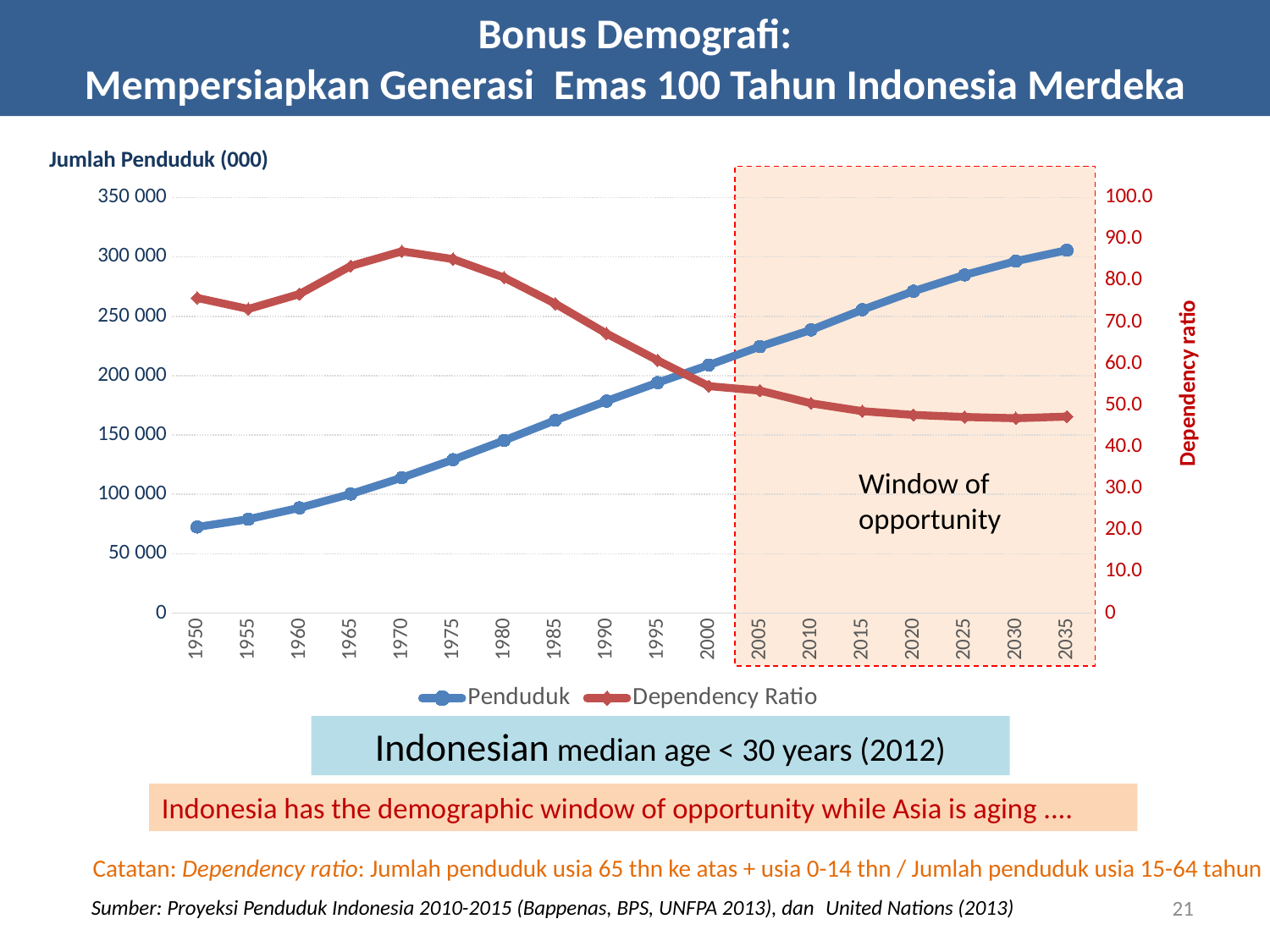
Does the Penduduk series rise or fall from 1950 to 2035? rise How many years are plotted along the x axis of the chart? 18 Is the Dependency Ratio for 2035 greater or less than 50.0? less In which year is the Penduduk value highest? 2035 Is the Penduduk value for 2000 greater or less than 200 000? greater In which year is the Penduduk value lowest? 1950 Which is larger, the Dependency Ratio in 1970 or in 2035? 1970 How many series does the chart legend list? 2 What kind of chart is shown on the slide? line chart What are the two series named in the chart legend? Penduduk and Dependency Ratio Does the Dependency Ratio series rise or fall from 1970 to 2035? fall In which year is the Dependency Ratio highest? 1970